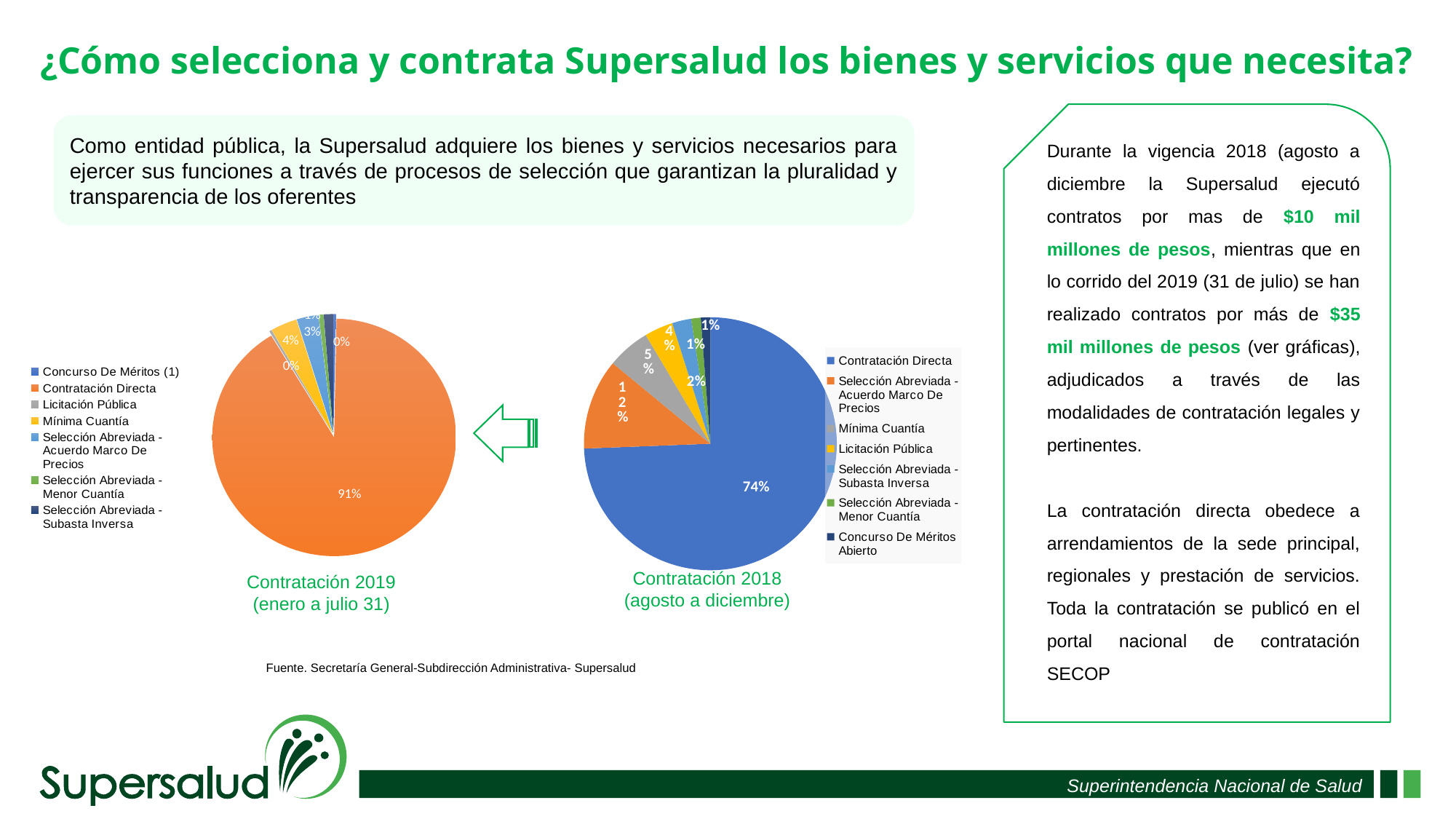
In the 'Contratación 2018 (agosto a diciembre)' pie chart, what share does Licitación Pública have? 4% In the 'Contratación 2018 (agosto a diciembre)' pie chart, what share does Selección Abreviada - Acuerdo Marco De Precios have? 12% In the 'Contratación 2019 (enero a julio 31)' pie chart, what share does Contratación Directa have? 91% In the 'Contratación 2018 (agosto a diciembre)' pie chart, which category has the largest share? Contratación Directa How many categories does the legend of the 'Contratación 2018 (agosto a diciembre)' chart list? 7 In the 'Contratación 2018 (agosto a diciembre)' pie chart, which is larger: Mínima Cuantía or Licitación Pública? Mínima Cuantía In the 'Contratación 2018 (agosto a diciembre)' pie chart, what share does Contratación Directa have? 74% What type of chart is used for 'Contratación 2019 (enero a julio 31)'? Pie chart In the 'Contratación 2018 (agosto a diciembre)' pie chart, what share does Selección Abreviada - Subasta Inversa have? 2% In the 'Contratación 2018 (agosto a diciembre)' pie chart, what is the difference in percentage points between Contratación Directa and Selección Abreviada - Acuerdo Marco De Precios? 62 percentage points In the 'Contratación 2019 (enero a julio 31)' pie chart, which category has the largest share? Contratación Directa In the 'Contratación 2018 (agosto a diciembre)' pie chart, what share does Mínima Cuantía have? 5%